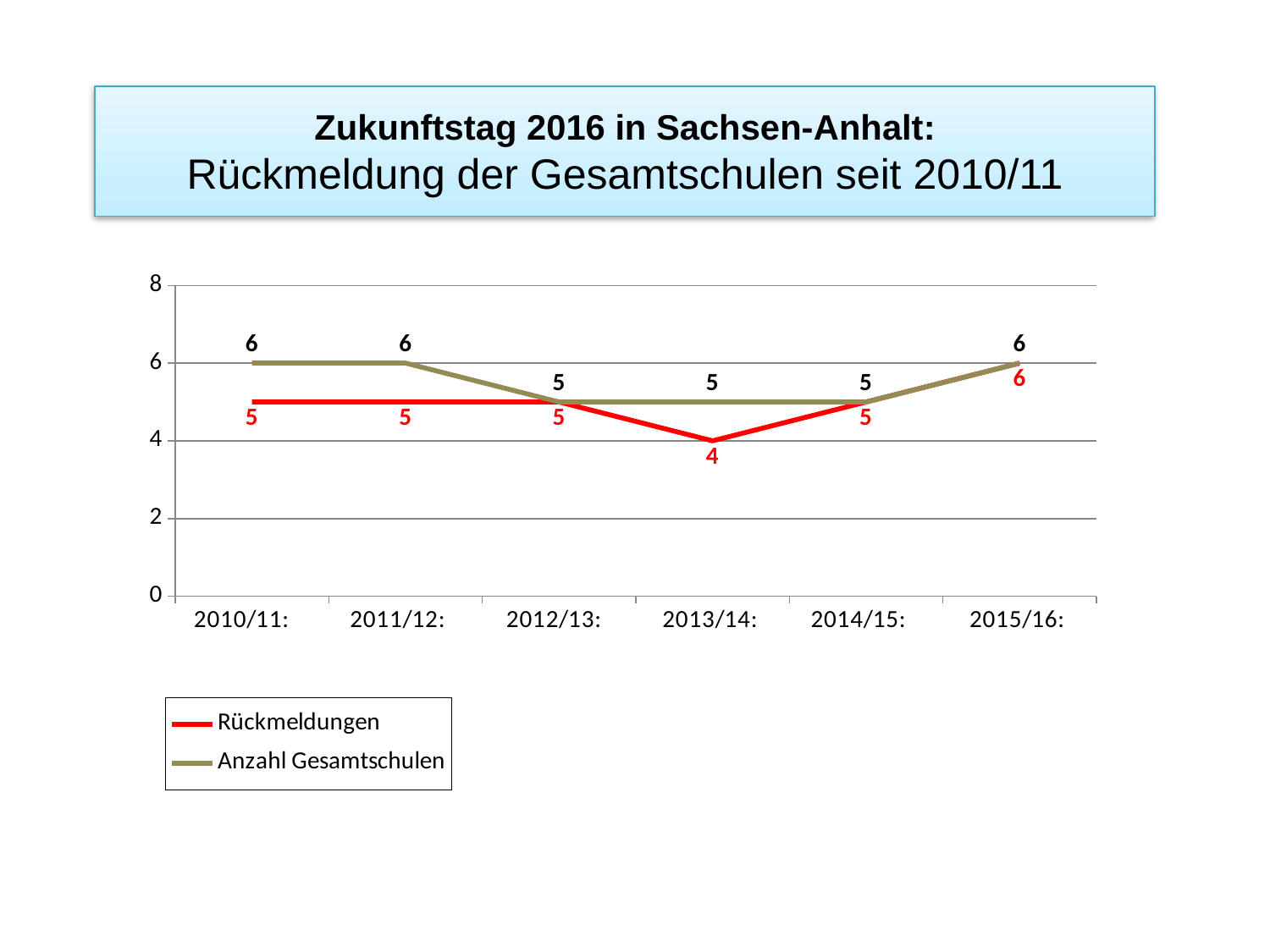
What is the value of Rückmeldungen for 2015/16? 6 What colour is the line for Rückmeldungen? red What kind of chart is shown on the slide? line chart How many school years are shown on the x axis? 6 How many series does the legend list? 2 What is the value of Anzahl Gesamtschulen for 2011/12? 6 What is the difference between Anzahl Gesamtschulen and Rückmeldungen in 2010/11? 1 Does the Rückmeldungen series rise or fall from 2013/14 to 2015/16? rise In which school year is the Rückmeldungen value lowest? 2013/14 Which is larger in 2012/13: Rückmeldungen or Anzahl Gesamtschulen? They are equal (5) Is the value of Rückmeldungen for 2013/14 greater or less than 6? less What is the value of Rückmeldungen for 2013/14? 4